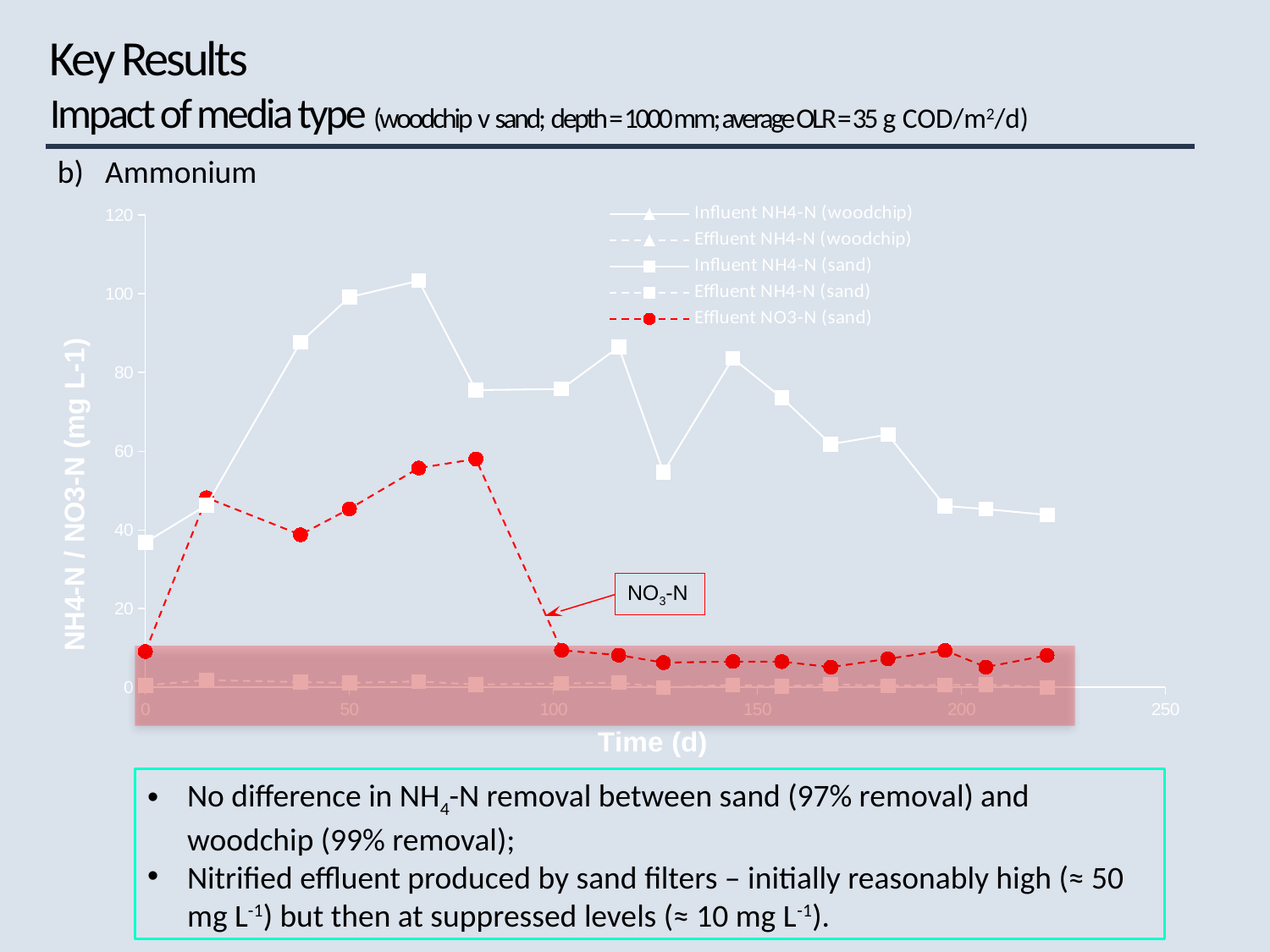
Does the Influent NH4-N (sand) series rise or fall between day 0 and about day 65? rise At around day 100, which is larger: Influent NH4-N (sand) or Effluent NO3-N (sand)? Influent NH4-N (sand) Does the Effluent NO3-N (sand) series rise or fall between about day 80 and day 100? fall What is the title of the y-axis of the chart? NH4-N / NO3-N (mg L-1) What is the title of the x-axis of the chart? Time (d) Is the Effluent NH4-N (sand) series greater or less than 20 across the whole time period? less How many series does the chart legend list? 5 Which series reaches the highest value on the chart? Influent NH4-N (sand) Is the value of Effluent NO3-N (sand) at day 0 greater or less than 20? less Is the highest value of the Effluent NO3-N (sand) series greater or less than 40? greater What kind of chart is shown on the slide? line chart